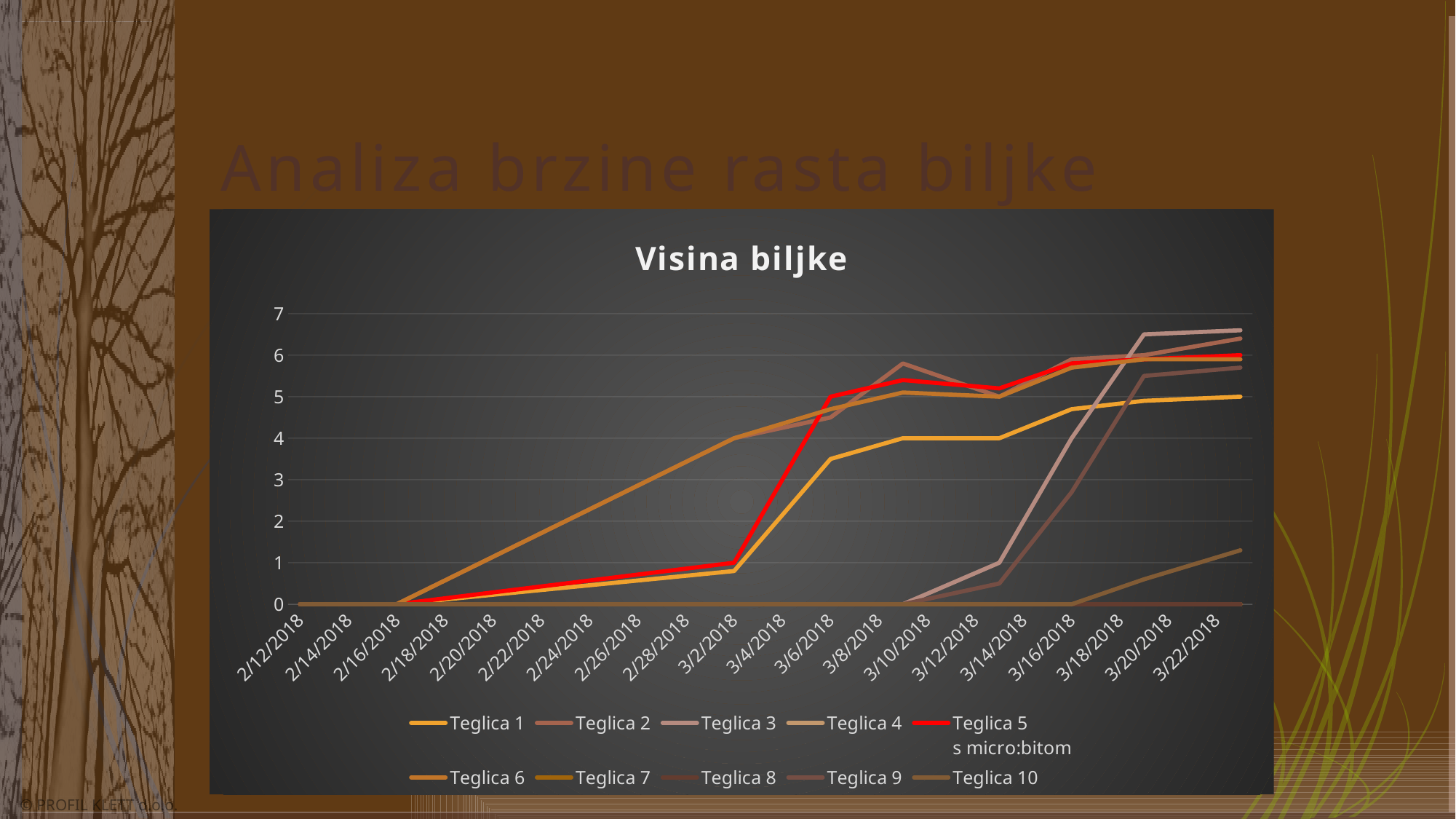
What kind of chart is shown on the slide? line chart Is the value for Teglica 5 s micro:bitom on 3/6/2018 greater or less than 4? greater On 3/22/2018, which is larger: Teglica 1 or Teglica 5 s micro:bitom? Teglica 5 s micro:bitom Which series is drawn in red? Teglica 5 s micro:bitom Is the value for Teglica 10 on 3/22/2018 greater or less than 2? less How many dates are labelled along the x axis? 20 What is the title of the chart? Visina biljke Is the value for Teglica 1 on 3/22/2018 greater or less than 4? greater Does the value for Teglica 1 rise or fall from 2/18/2018 to 3/22/2018? rise How many series does the legend list? 10 On 3/22/2018, which is larger: Teglica 10 or Teglica 1? Teglica 1